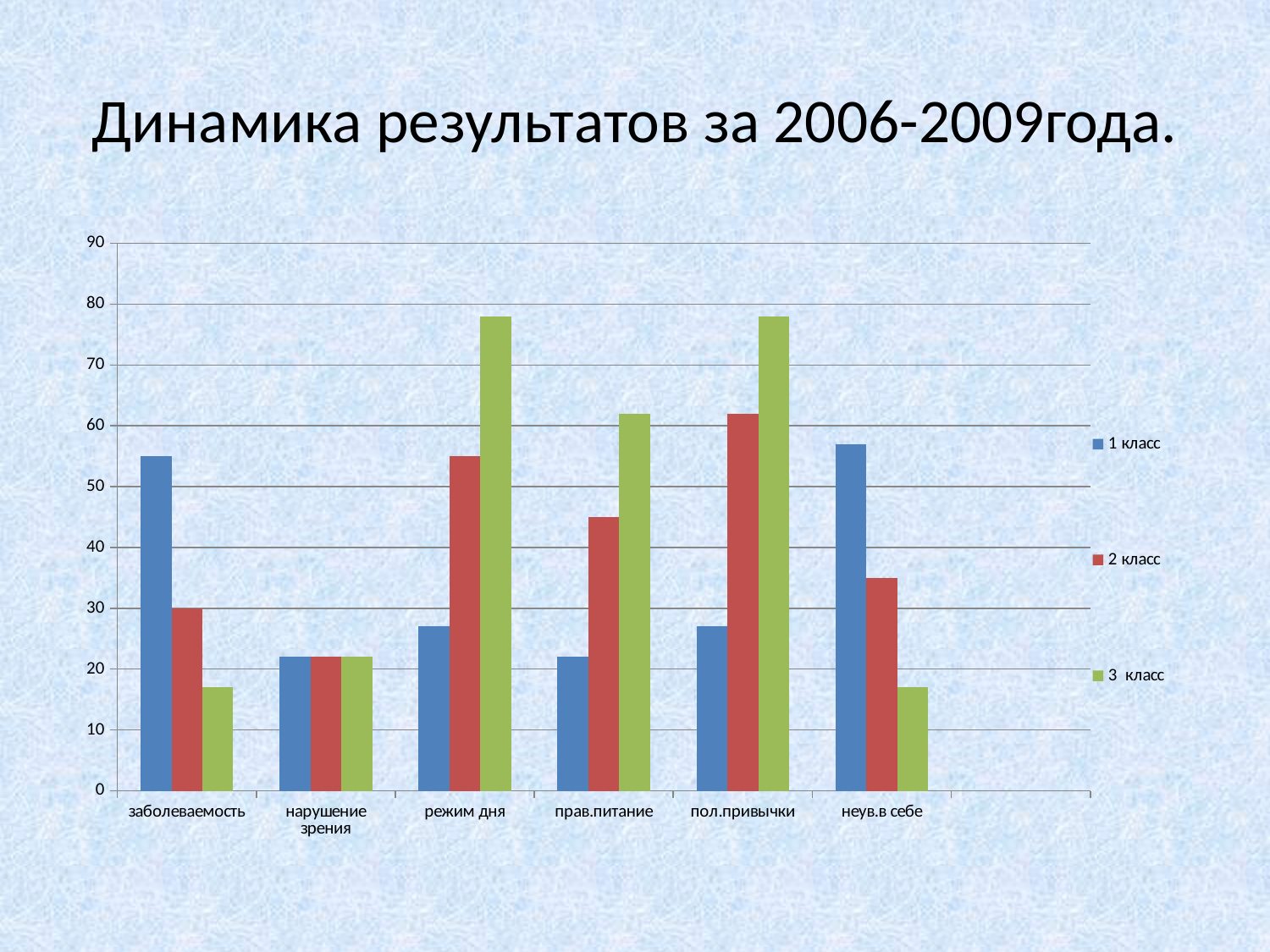
In the category режим дня, which series has the highest bar? 3 класс Which series is shown in green in the chart? 3 класс For which category is the value for 2 класс the highest? пол.привычки For which category is the value for 2 класс the lowest? нарушение зрения In the category заболеваемость, which series has the highest bar? 1 класс What kind of chart is shown on the slide? bar chart How many categories are shown along the x axis of the chart? 6 Is the value for 3 класс in режим дня greater or less than 70? greater How many series does the chart legend list? 3 Is the value for 3 класс in заболеваемость greater or less than 20? less For заболеваемость, which is larger: the value for 1 класс or the value for 3 класс? 1 класс What is the title of the slide above the chart? Динамика результатов за 2006-2009года.